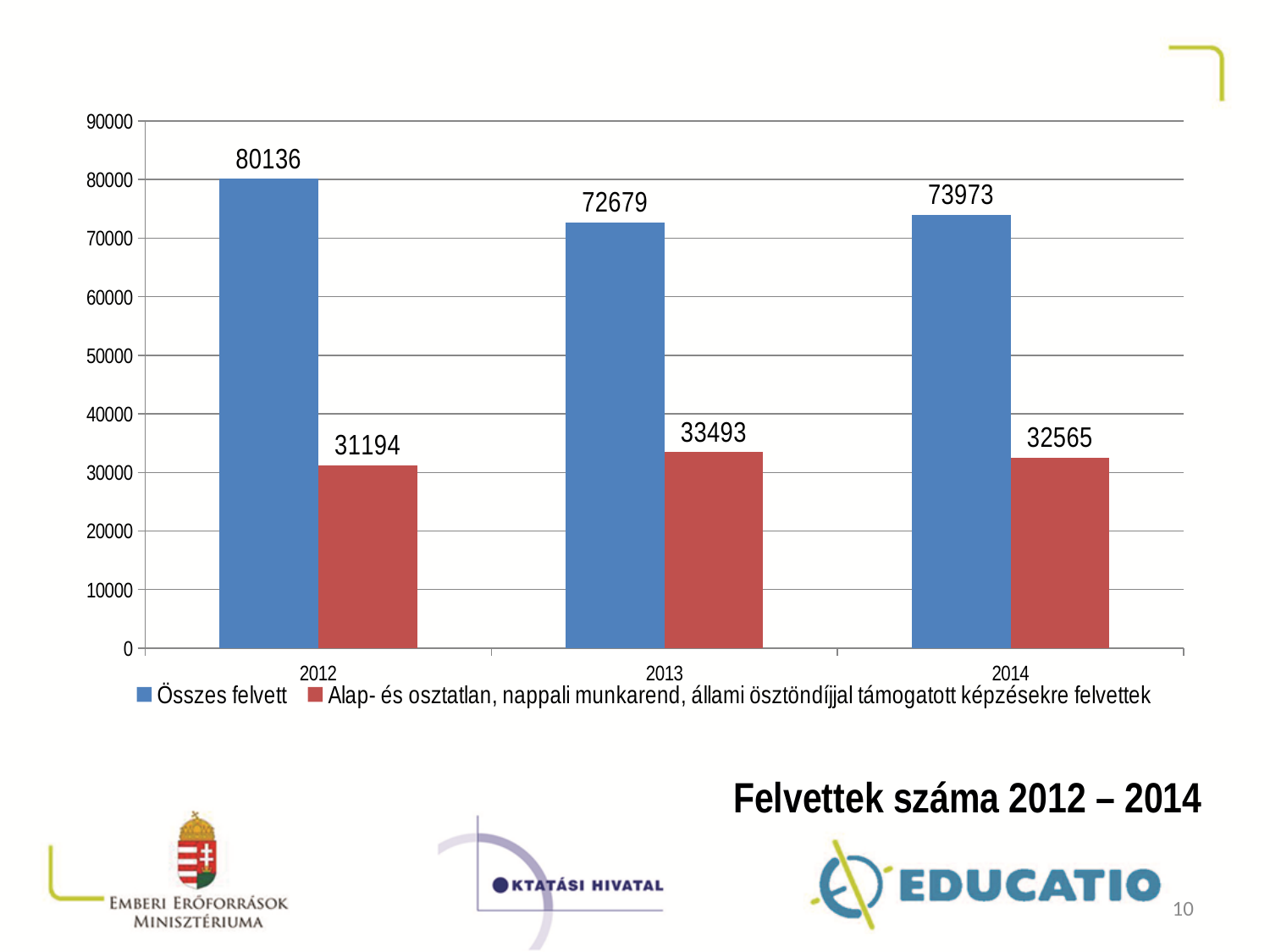
Is the value of Összes felvett for 2013 greater or less than 70000? greater What colour are the Összes felvett bars? blue How many years are shown on the x axis? 3 What is the value of Összes felvett for 2012? 80136 In which year is Alap- és osztatlan, nappali munkarend, állami ösztöndíjjal támogatott képzésekre felvettek lowest? 2012 In which year is Összes felvett highest? 2012 What is the difference between Összes felvett in 2012 and 2013? 7457 What is the value of Összes felvett for 2014? 73973 What kind of chart is shown on the slide? bar chart What is the value of Alap- és osztatlan, nappali munkarend, állami ösztöndíjjal támogatott képzésekre felvettek for 2013? 33493 Which is larger: Összes felvett in 2013 or in 2014? 2014 How many series does the legend list? 2